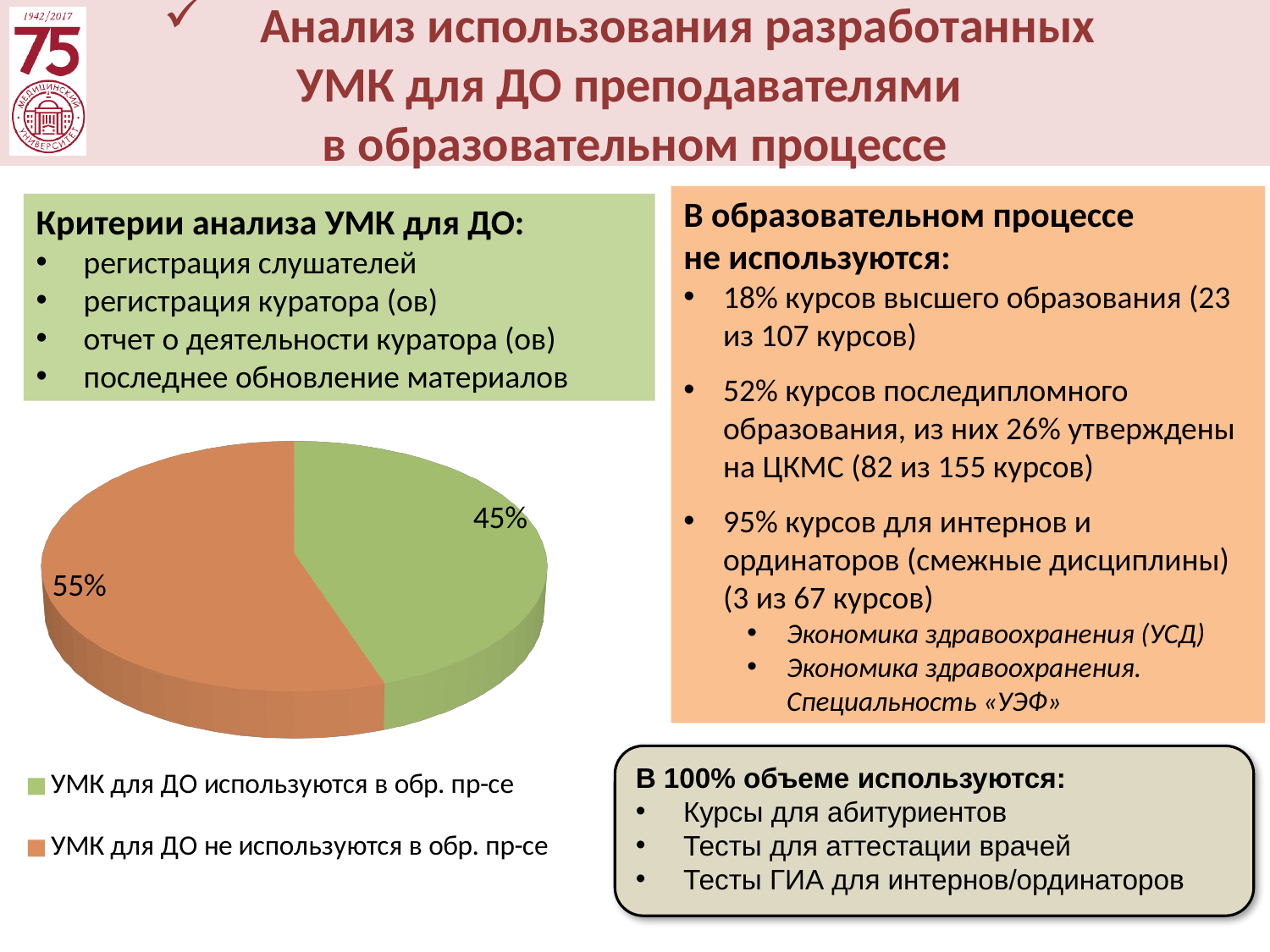
Is the share of УМК not used in the educational process greater or less than 50%? greater What share of the pie is labelled "УМК для ДО не используются в обр. пр-се"? 55% How many slices does the pie chart have? 2 Which slice of the pie is the largest? УМК для ДО не используются в обр. пр-се Which slice of the pie is the smallest? УМК для ДО используются в обр. пр-се What is the difference in percentage points between the "не используются" slice and the "используются" slice? 10 How many entries does the chart legend list? 2 What colour is the slice for "УМК для ДО не используются в обр. пр-се"? orange Which is larger: the share of УМК used in the educational process or the share not used? УМК для ДО не используются в обр. пр-се What kind of chart is shown on the slide? pie chart What colour is the slice for "УМК для ДО используются в обр. пр-се"? green What share of the pie is labelled "УМК для ДО используются в обр. пр-се"? 45%